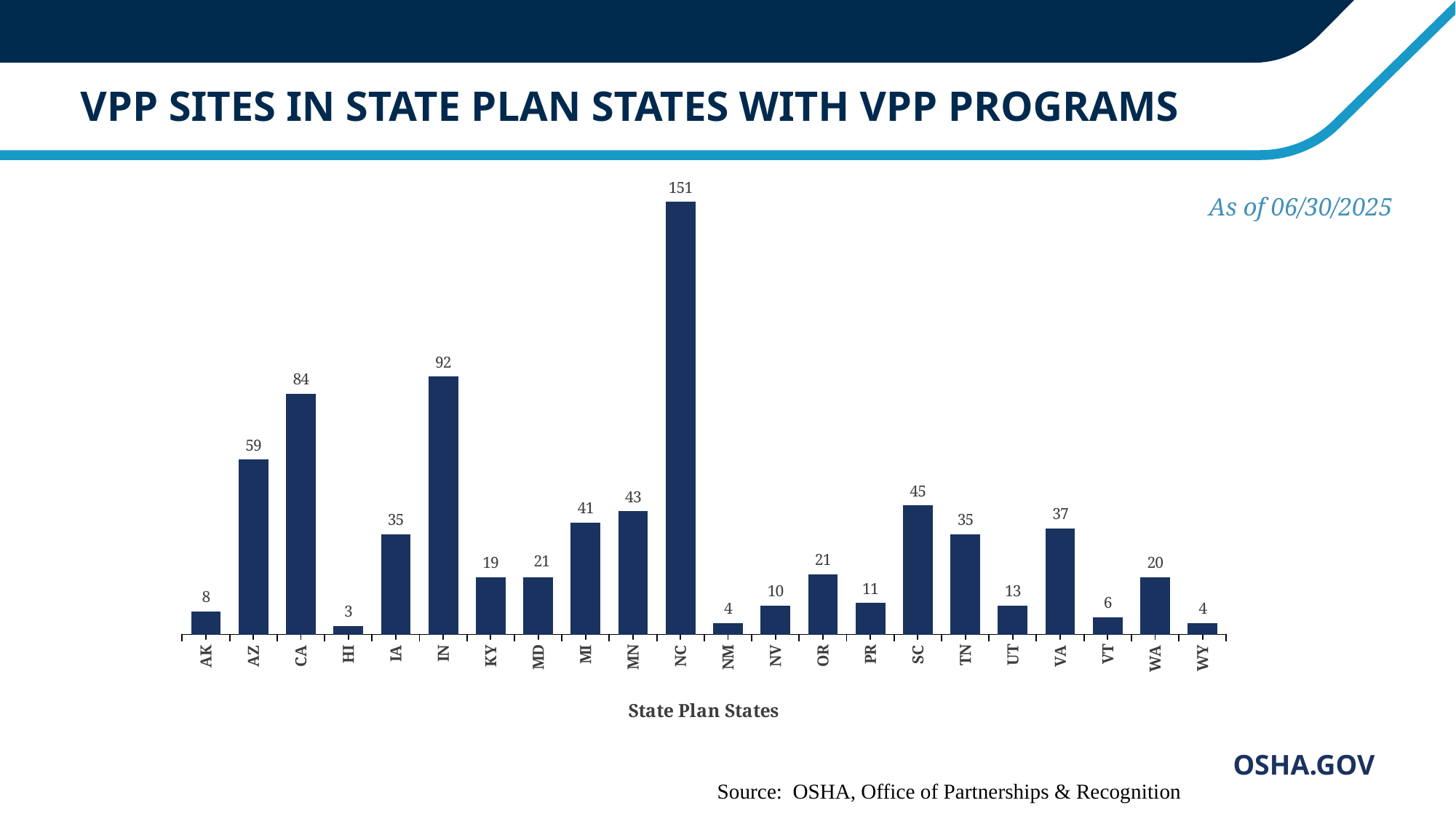
Which has more VPP sites, VA or TN? VA Which has more VPP sites, SC or MN? SC How many states are shown on the x axis? 22 What is the difference between the values for NC and IN? 59 What is the value shown for Indiana (IN)? 92 Which state has the highest number of VPP sites? NC What type of chart is shown on the slide? Bar chart What is the value shown for Hawaii (HI)? 3 What is the x-axis title of the chart? State Plan States How many VPP sites does North Carolina (NC) have? 151 What is the difference between the values for CA and AZ? 25 Which state has the lowest number of VPP sites? HI